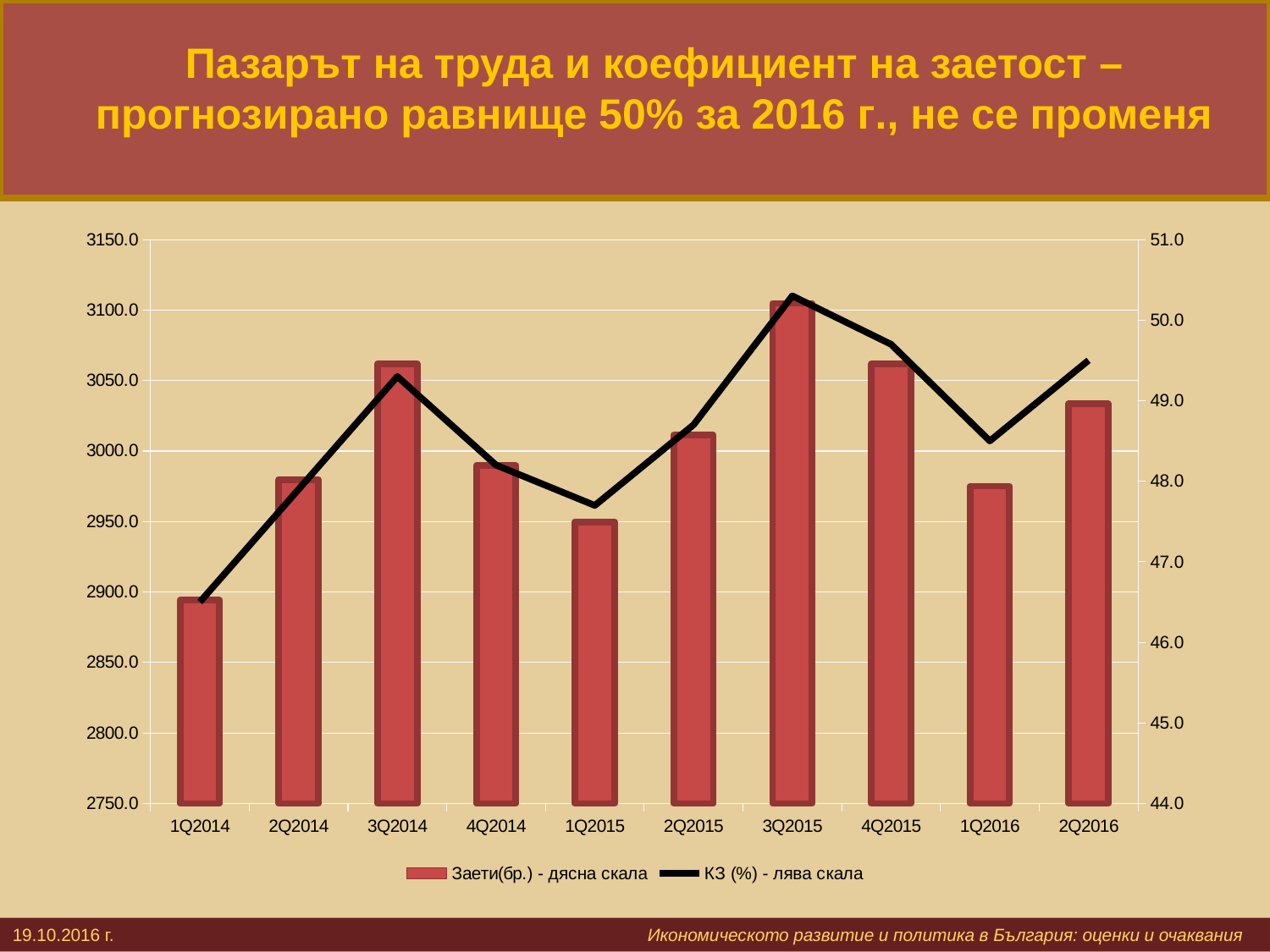
In which quarter does the black line reach its lowest point? 1Q2014 Does the black line rise or fall from 4Q2015 to 1Q2016? It falls In which quarter is the bar the tallest? 3Q2015 What kind of chart is shown on the slide? A combination bar and line chart Is the bar for 3Q2015 greater or less than 3050.0 on the left axis? greater In which quarter does the black line reach its highest point? 3Q2015 How many quarters are shown on the x axis of the chart? 10 Which bar is taller, 3Q2014 or 4Q2014? 3Q2014 Is the bar for 1Q2015 greater or less than 3000.0 on the left axis? less How many series does the chart legend list? 2 In which quarter is the bar the shortest? 1Q2014 Is the black line value for 1Q2016 greater or less than 49.0 on the right axis? less